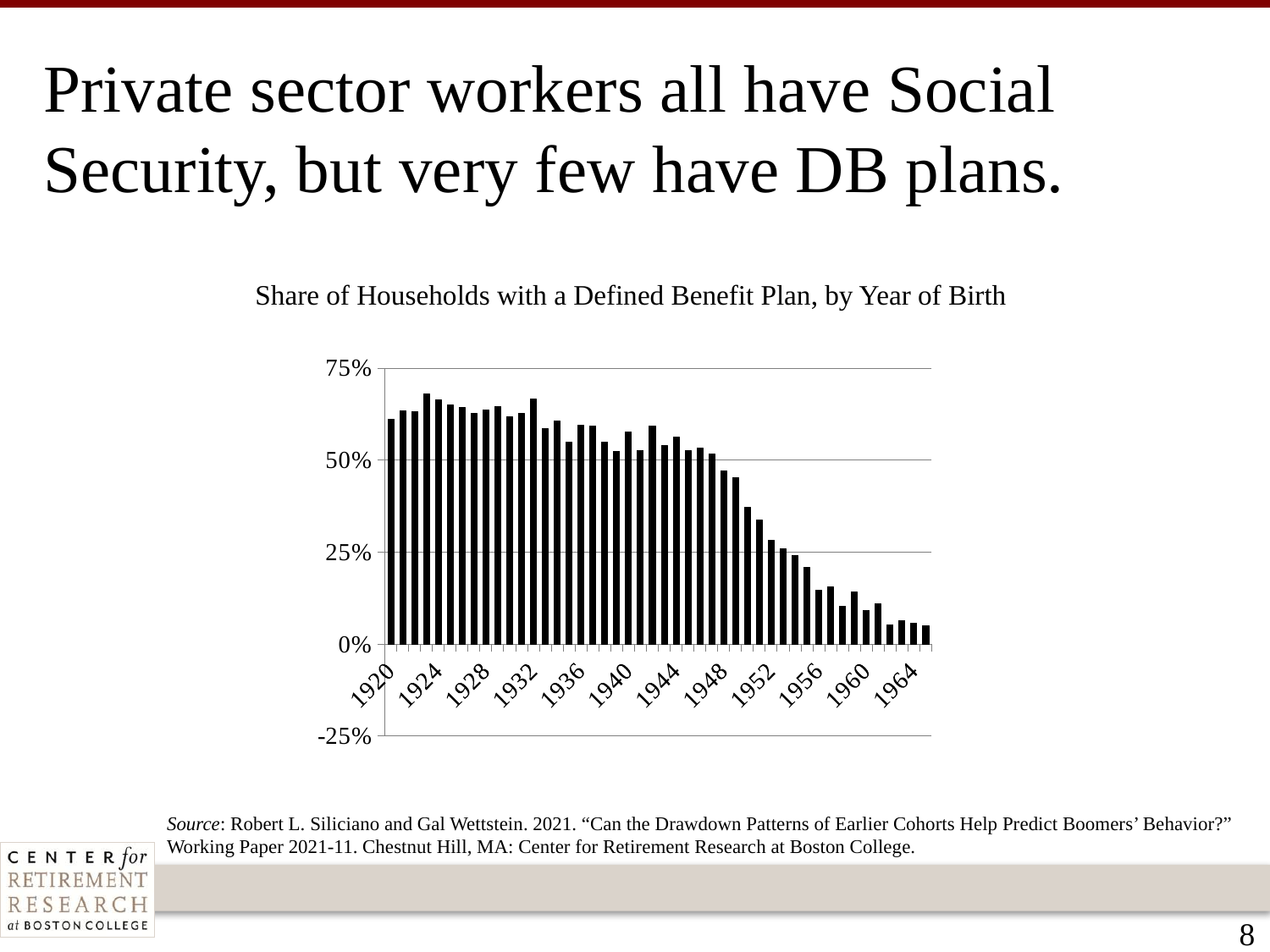
Do the values generally rise or fall as the year of birth increases from 1920 to 1964? fall Which has the larger value, 1952 or 1928? 1928 What kind of chart is shown on the slide? bar chart Which has the larger value, 1920 or 1960? 1920 What is the highest value shown on the vertical axis? 75% Is the value for 1956 greater or less than 25%? less Is the value for 1960 greater or less than 25%? less Is the value for 1964 greater or less than 25%? less What is the title of the chart? Share of Households with a Defined Benefit Plan, by Year of Birth